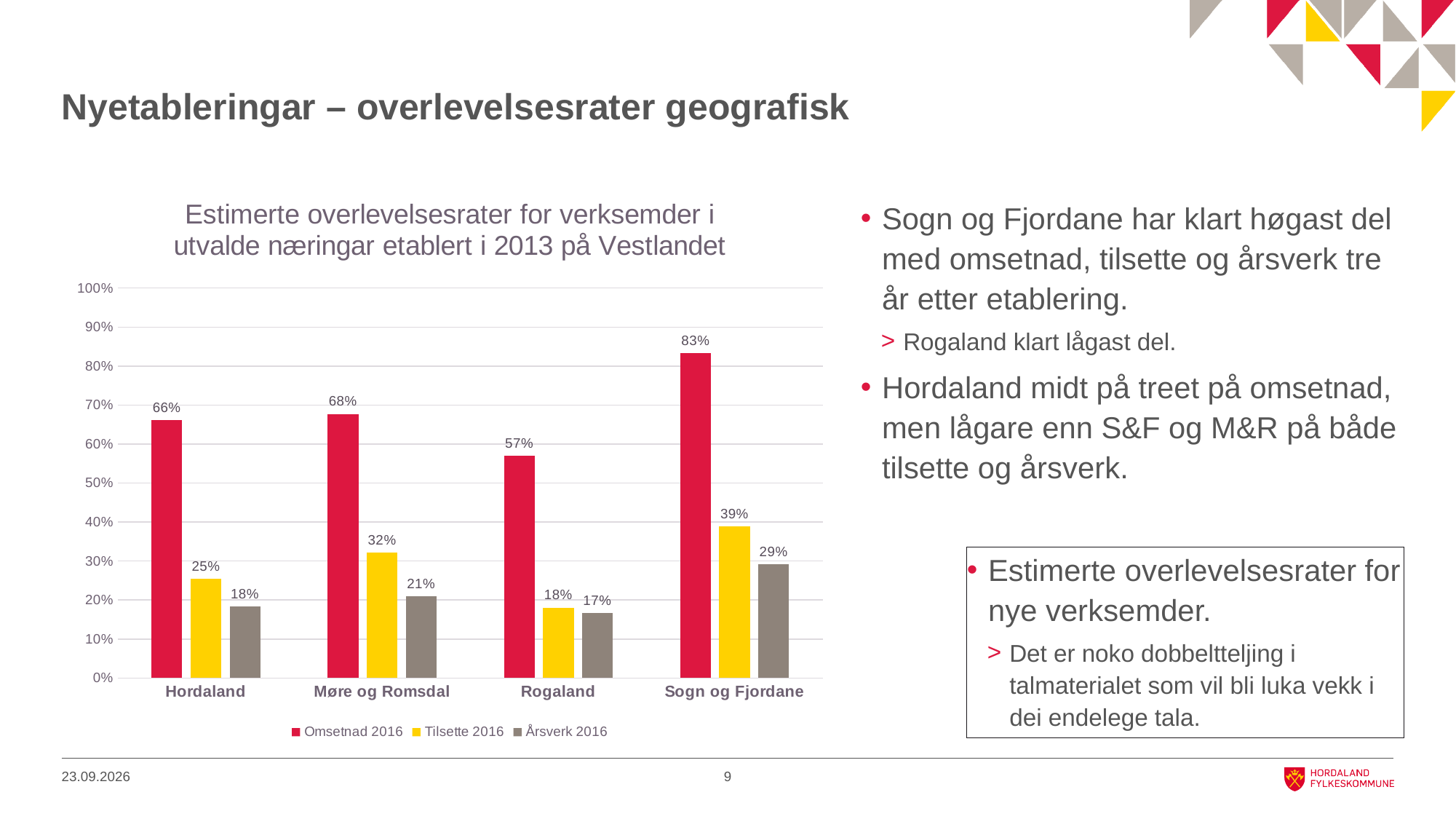
What is the Årsverk 2016 value for Rogaland? 17% Which region has the lowest Tilsette 2016 value? Rogaland What kind of chart is shown on the slide? Bar chart What is the Omsetnad 2016 value for Sogn og Fjordane? 83% Which is larger: the Årsverk 2016 value for Hordaland or for Møre og Romsdal? Møre og Romsdal How many regions are shown on the x axis? 4 What is the Tilsette 2016 value for Møre og Romsdal? 32% How many series does the legend list? 3 What is the difference between the Omsetnad 2016 values for Sogn og Fjordane and Rogaland? 26% What colour represents the Tilsette 2016 series? Yellow Which region has the highest Omsetnad 2016 value? Sogn og Fjordane Is the Tilsette 2016 value for Sogn og Fjordane greater or less than 30%? greater